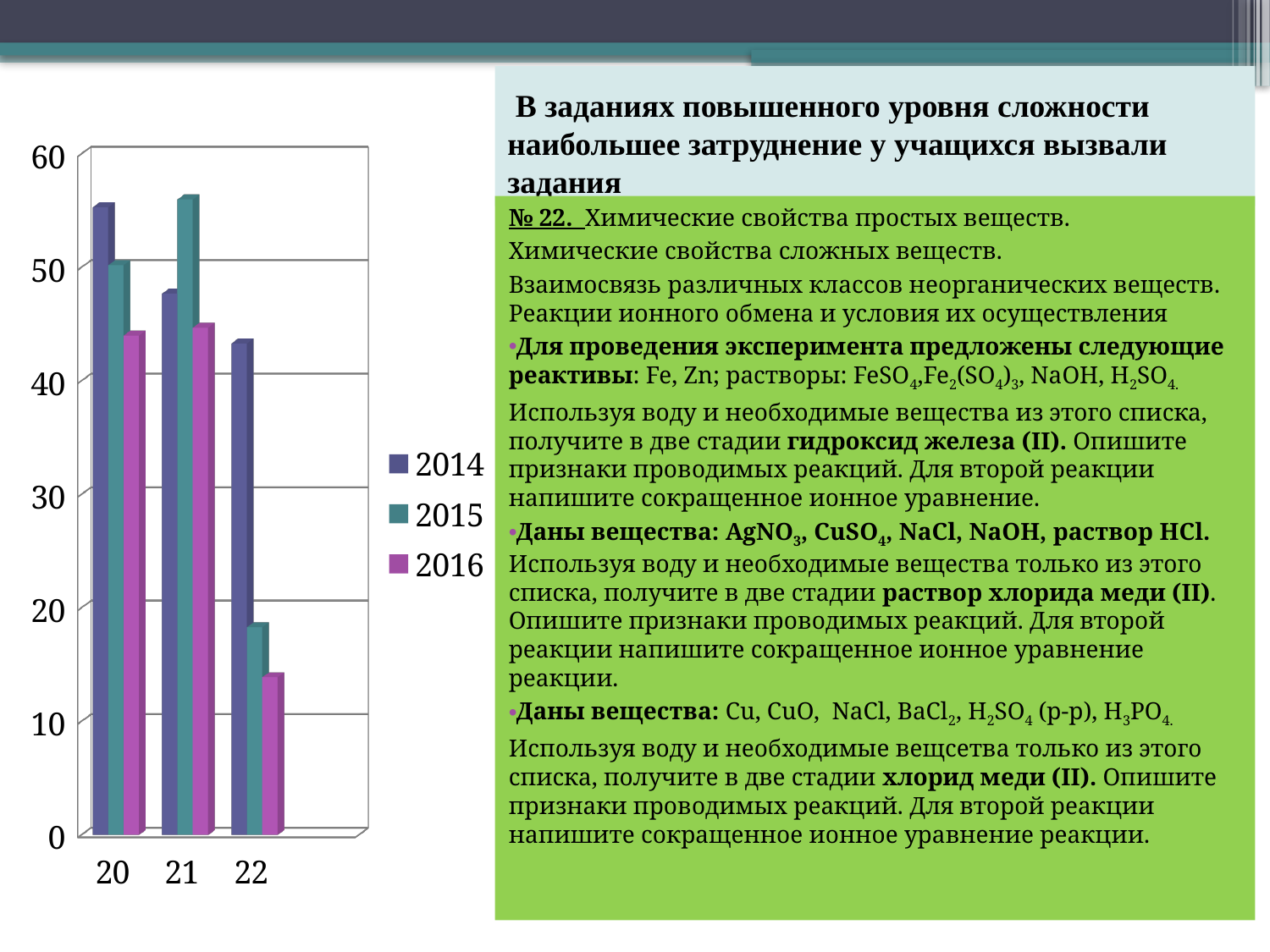
Is the value for 2016 in category 22 greater or less than 20? less Which series has the lowest value in category 22? 2016 How many series does the chart legend list? 3 Is the value for 2015 in category 22 greater or less than 20? less Which series has the highest value in category 21? 2015 How many categories are shown on the x axis of the chart? 3 Is the value for 2014 in category 20 greater or less than 50? greater What kind of chart is shown on the slide? bar chart Which is larger for the 2015 series: the value for category 21 or for category 22? 21 Which series does the legend list first? 2014 Which series has the highest value in category 22? 2014